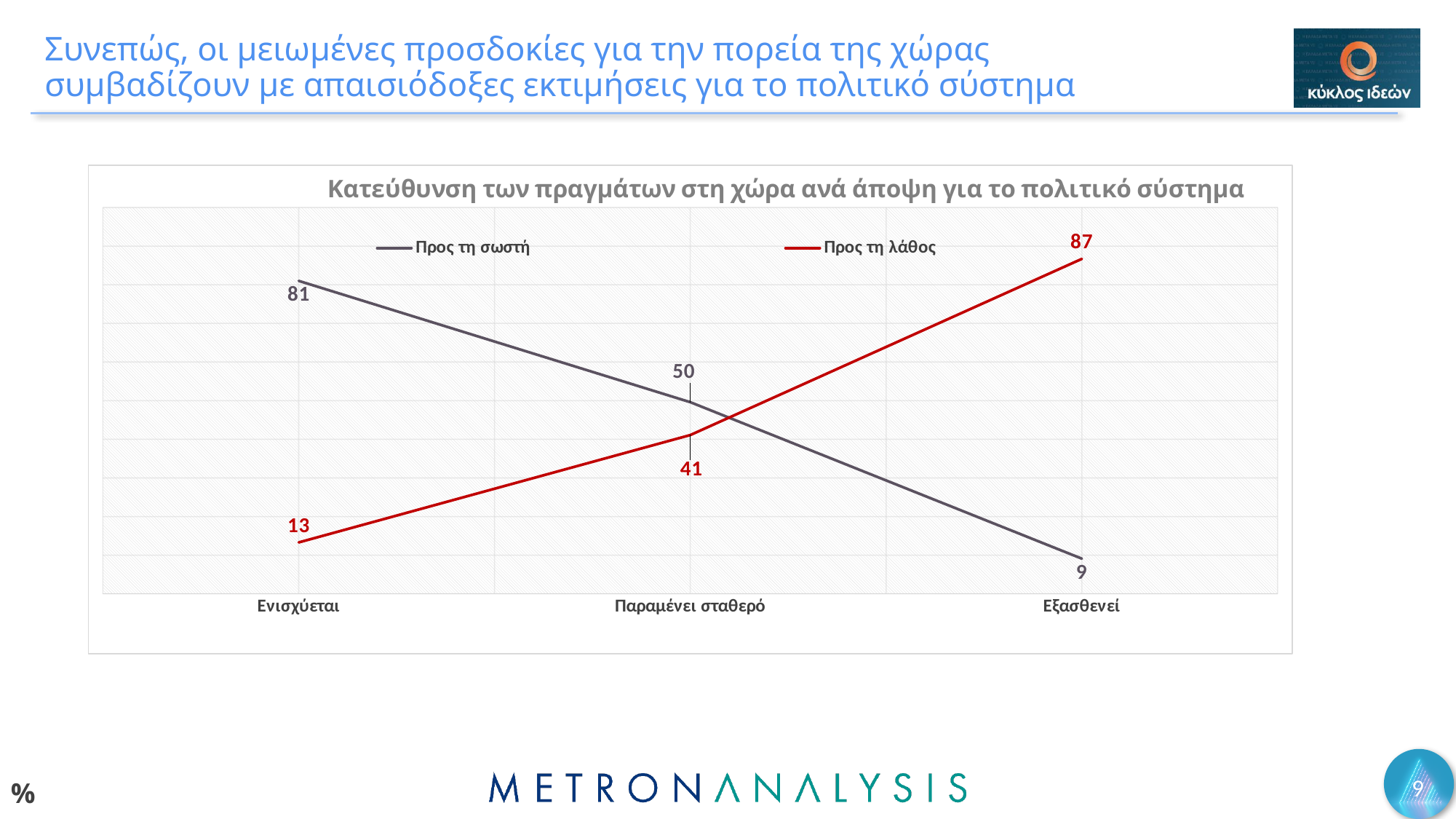
What is the value of the 'Προς τη σωστή' series for 'Παραμένει σταθερό'? 50 What is the value of the 'Προς τη λάθος' series for 'Ενισχύεται'? 13 Which series has the larger value for 'Παραμένει σταθερό', 'Προς τη σωστή' or 'Προς τη λάθος'? Προς τη σωστή For which category is the 'Προς τη σωστή' series lowest? Εξασθενεί For which category is the 'Προς τη λάθος' series highest? Εξασθενεί What is the value of the 'Προς τη σωστή' series for 'Ενισχύεται'? 81 How many series does the legend list? 2 What is the value of the 'Προς τη λάθος' series for 'Εξασθενεί'? 87 Does the 'Προς τη λάθος' series rise or fall from 'Ενισχύεται' to 'Εξασθενεί'? Rise What kind of chart is shown on the slide? Line chart How many categories are shown on the x axis? 3 What is the difference between the 'Προς τη σωστή' and 'Προς τη λάθος' values for 'Ενισχύεται'? 68